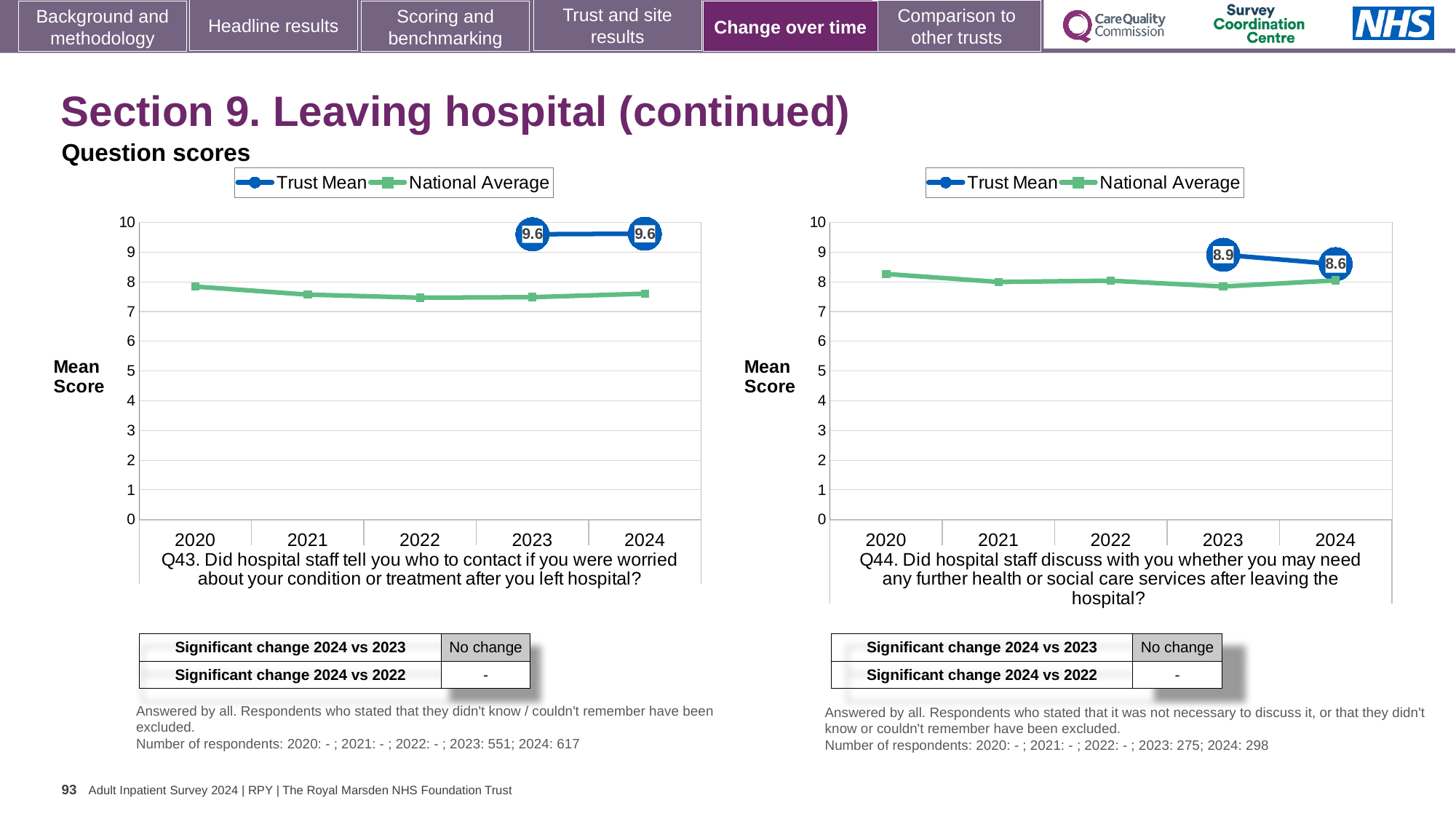
In the Q43 chart (left), what is the Trust Mean value for 2024? 9.6 In the Q44 chart (right), does the Trust Mean rise or fall from 2023 to 2024? fall How many years are shown on the x axis of the Q44 chart (right)? 5 How many series does the legend of the Q43 chart (left) list? 2 In the Q43 chart (left), which series has the higher value in 2024, Trust Mean or National Average? Trust Mean In the Q44 chart (right), what is the Trust Mean value for 2024? 8.6 In the Q44 chart (right), is the National Average value for 2023 greater or less than 8? less In the Q44 chart (right), what is the difference between the Trust Mean in 2023 and in 2024? 0.3 In the Q44 chart (right), what is the Trust Mean value for 2023? 8.9 In the Q43 chart (left), what is the Trust Mean value for 2023? 9.6 What type of chart is used for Q43 (left)? line chart In the Q43 chart (left), is the National Average value for 2020 greater or less than 7? greater